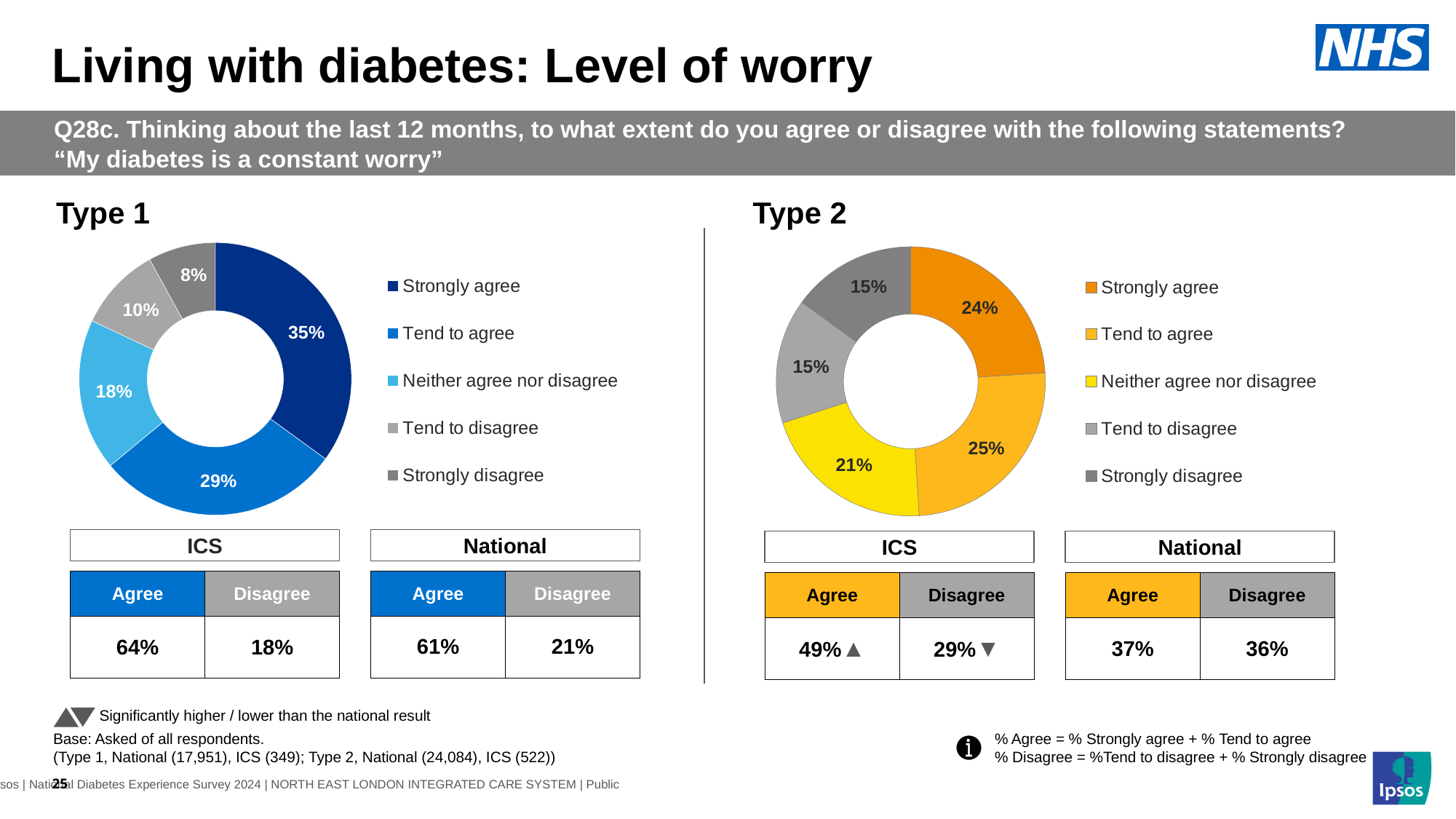
In the Type 2 chart, which response category has the largest share? Tend to agree In the Type 1 chart, what percentage of respondents said they tend to disagree? 10% In the Type 1 chart, which response category has the largest share? Strongly agree In the Type 2 chart, what percentage of respondents said they neither agree nor disagree? 21% How many response categories does the legend of the Type 2 chart list? 5 In the Type 2 chart, what is the difference between the Strongly agree and Strongly disagree shares? 9 percentage points What kind of chart is used to show the Type 1 results? Doughnut (pie) chart In the Type 1 chart, what is the difference between the Strongly agree and Tend to agree shares? 6 percentage points In the Type 2 chart, what percentage of respondents said they tend to agree? 25% In the Type 1 chart, what percentage of respondents said they strongly agree? 35% In the Type 1 chart, which response category has the smallest share? Strongly disagree Which is larger: the Neither agree nor disagree share in the Type 1 chart or in the Type 2 chart? Type 2